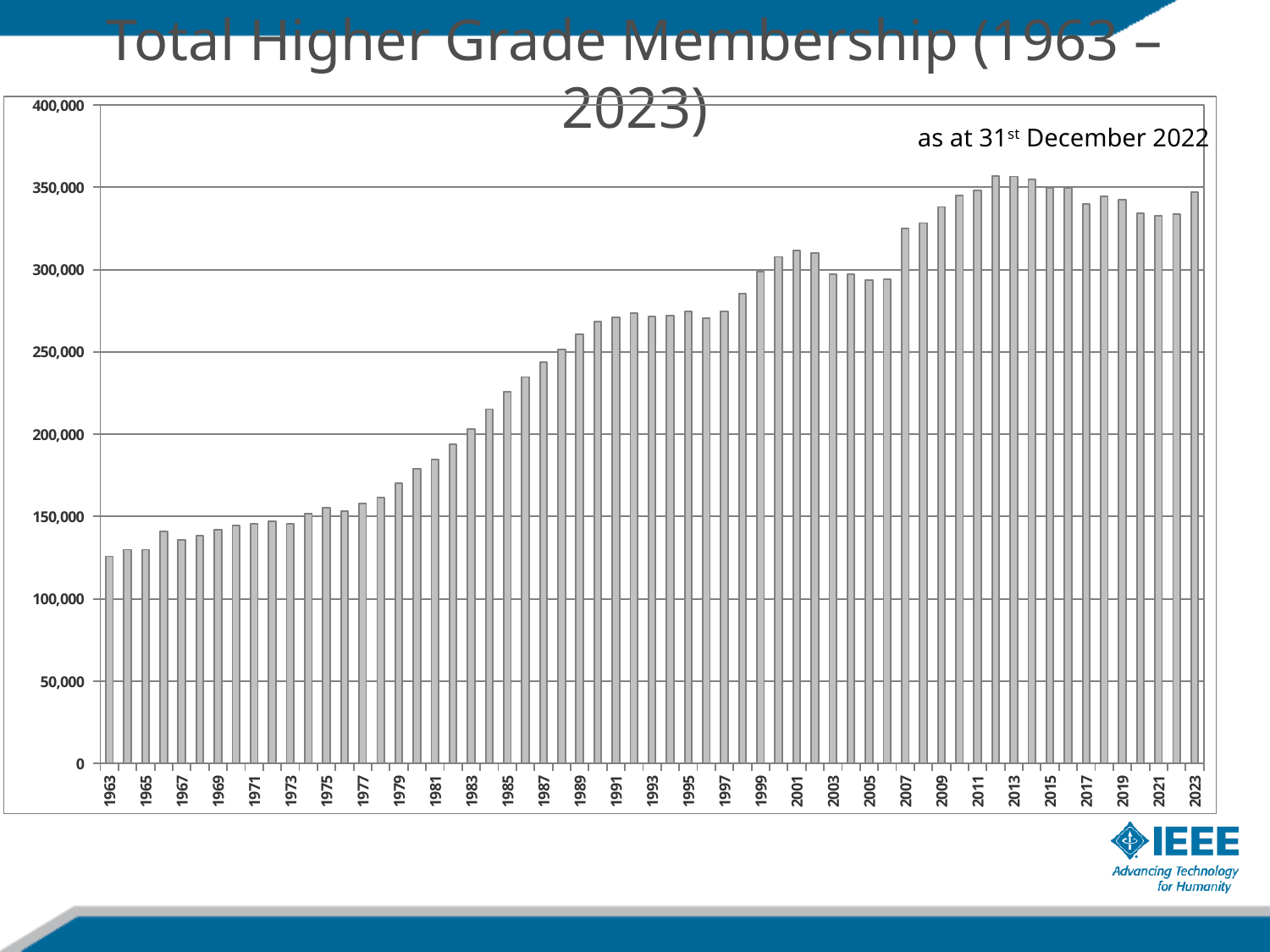
Is the membership value for 1969 greater or less than 150,000? less Is the membership value for 1985 greater or less than 200,000? greater What kind of chart is shown on the slide? Bar chart What is the highest value shown on the vertical axis? 400,000 What is the title of the chart? Total Higher Grade Membership (1963 – 2023) Overall, does membership rise or fall from 1963 to 2023? Rise Is the membership value for 1963 greater or less than 150,000? less Which year has the lowest membership in the chart? 1963 Which year has the larger membership, 2001 or 2005? 2001